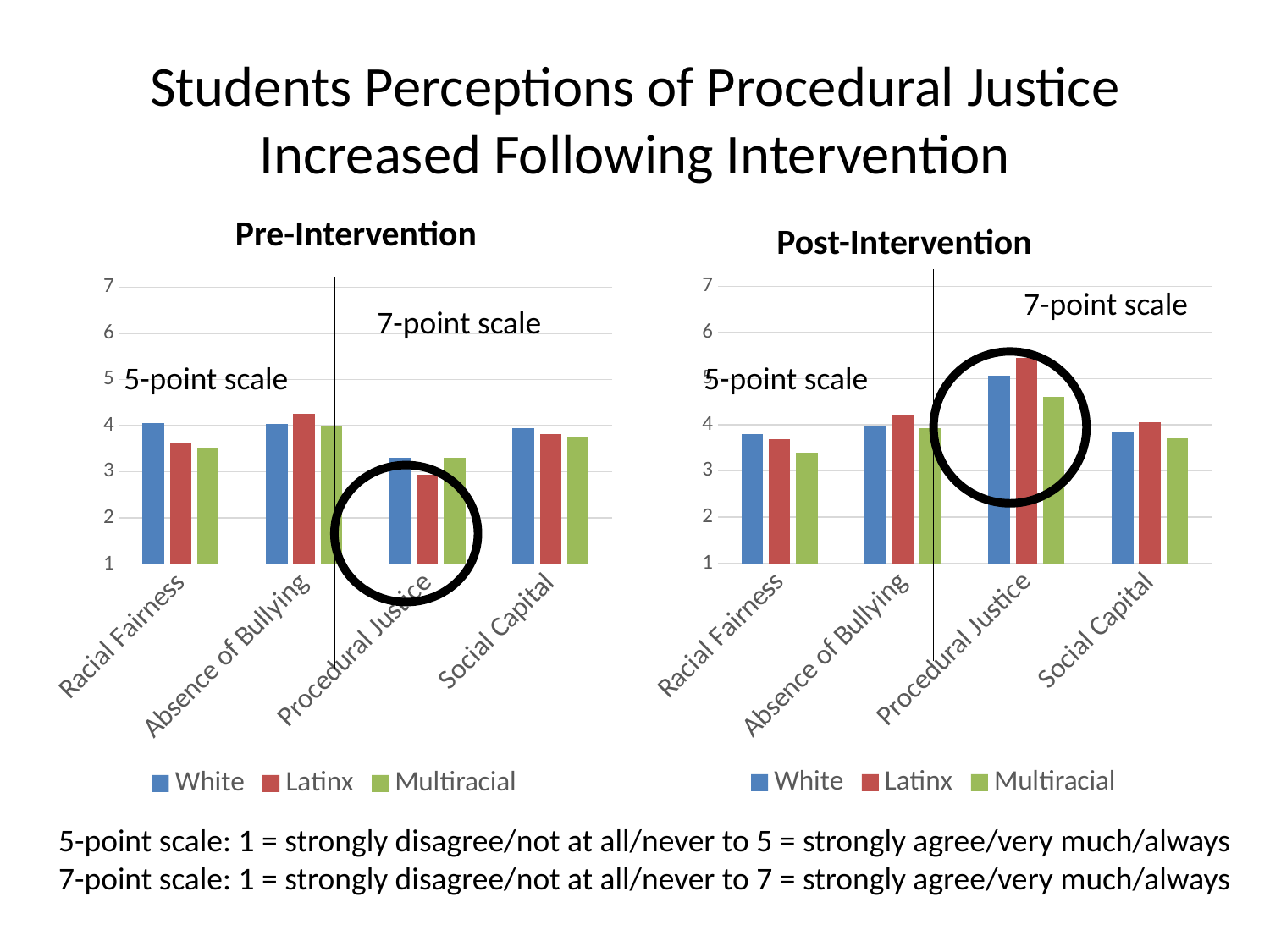
What are the three series listed in the legend of the Post-Intervention chart? White, Latinx, Multiracial How many series does the legend of the Pre-Intervention chart list? 3 In the Pre-Intervention chart, which category has the lowest Latinx bar? Procedural Justice In the Post-Intervention chart, which category has the highest Latinx bar? Procedural Justice In the Post-Intervention chart, for Procedural Justice, which is larger: the White bar or the Latinx bar? Latinx In the Pre-Intervention chart, is the Latinx value for Absence of Bullying greater or less than 4? greater In the Pre-Intervention chart, for Racial Fairness, which is larger: the White bar or the Multiracial bar? White In the Post-Intervention chart, is the Latinx value for Procedural Justice greater or less than 5? greater What kind of chart is the Pre-Intervention chart? bar chart How many categories are shown on the x axis of the Post-Intervention chart? 4 In the Post-Intervention chart, is the Multiracial value for Racial Fairness greater or less than 4? less